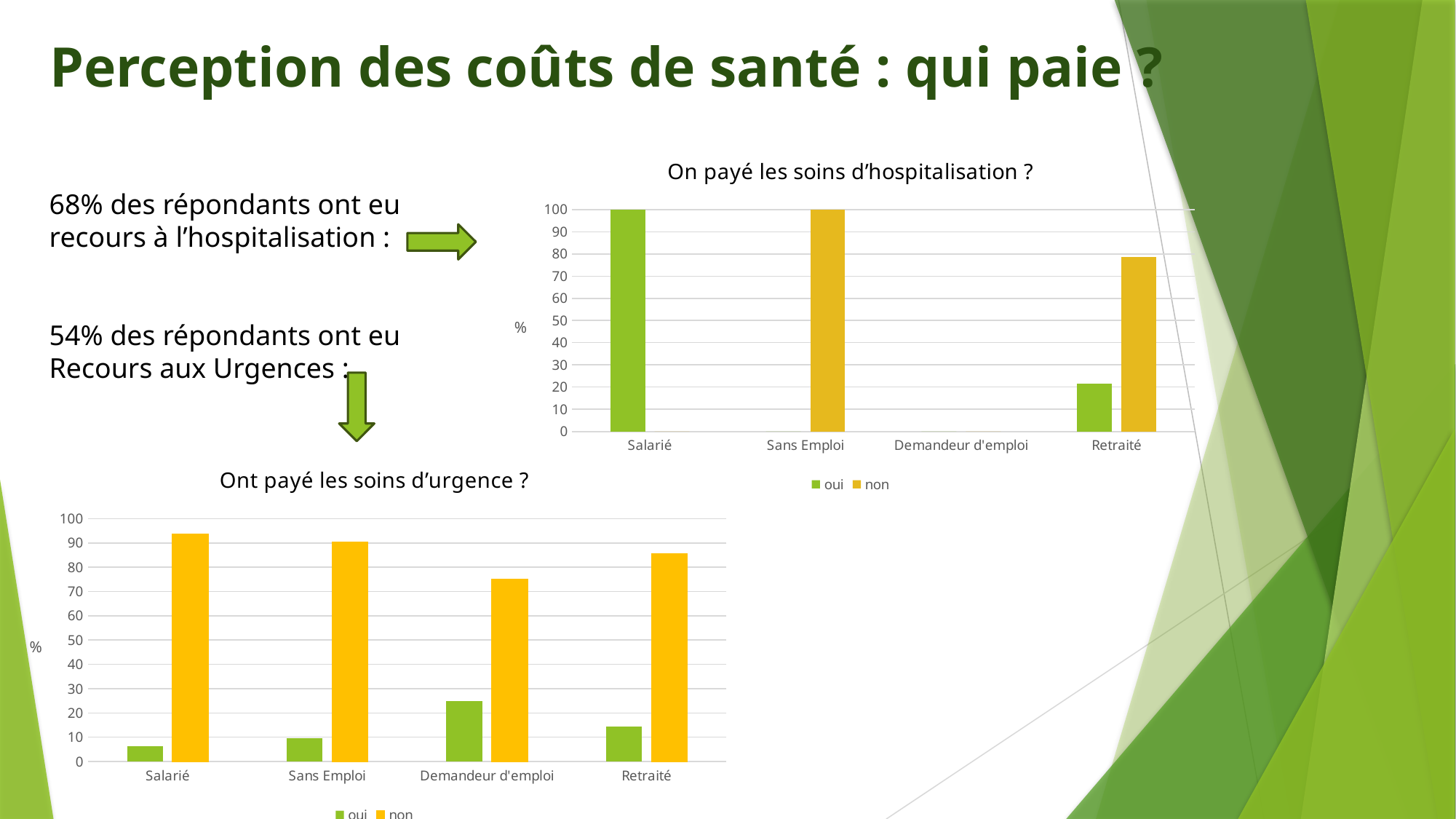
In the chart 'On payé les soins d'hospitalisation ?', is the value of 'non' for Retraité greater or less than 70? greater In the chart 'Ont payé les soins d'urgence ?', which category has the highest 'non' value? Salarié In the chart 'Ont payé les soins d'urgence ?', is the 'non' value for Demandeur d'emploi greater or less than 70? greater How many series does the legend of the chart 'On payé les soins d'hospitalisation ?' list? 2 In the chart 'Ont payé les soins d'urgence ?', is the 'oui' value for Retraité larger than the 'oui' value for Sans Emploi? Yes In the chart 'Ont payé les soins d'urgence ?', which category has the lowest 'oui' value? Salarié In the chart 'Ont payé les soins d'urgence ?', which category has the highest 'oui' value? Demandeur d'emploi In the chart 'On payé les soins d'hospitalisation ?', is the value of 'oui' for Retraité greater or less than 30? less In the chart 'On payé les soins d'hospitalisation ?', what is the value of 'non' for Sans Emploi? 100 In the chart 'On payé les soins d'hospitalisation ?', what is the value of 'oui' for Salarié? 100 How many categories are shown on the x axis of the chart 'Ont payé les soins d'urgence ?'? 4 What type of chart is 'Ont payé les soins d'urgence ?'? Bar chart